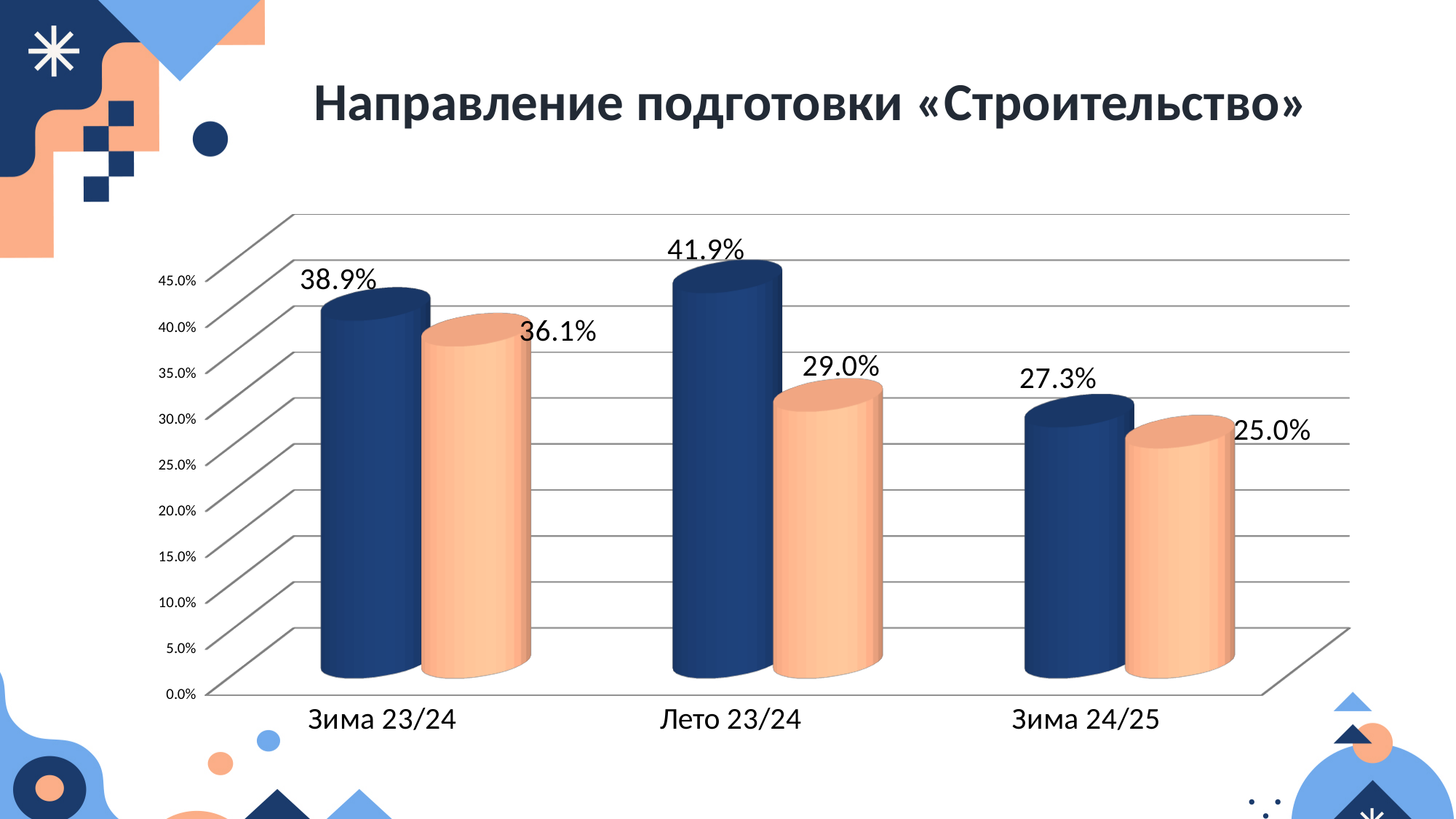
What is the value of the dark blue bar for Зима 23/24? 38.9% Which is larger for Зима 23/24: the dark blue bar or the peach bar? the dark blue bar What is the value of the dark blue bar for Зима 24/25? 27.3% Which category has the lowest peach bar? Зима 24/25 What is the value of the peach bar for Лето 23/24? 29.0% How many categories are shown on the x axis? 3 How many bars are plotted for each category? 2 What is the difference between the dark blue and peach bars for Лето 23/24? 12.9% What kind of chart is shown on the slide? bar chart What is the title of the slide? Направление подготовки «Строительство» Which category has the highest dark blue bar? Лето 23/24 What is the value of the peach bar for Зима 24/25? 25.0%